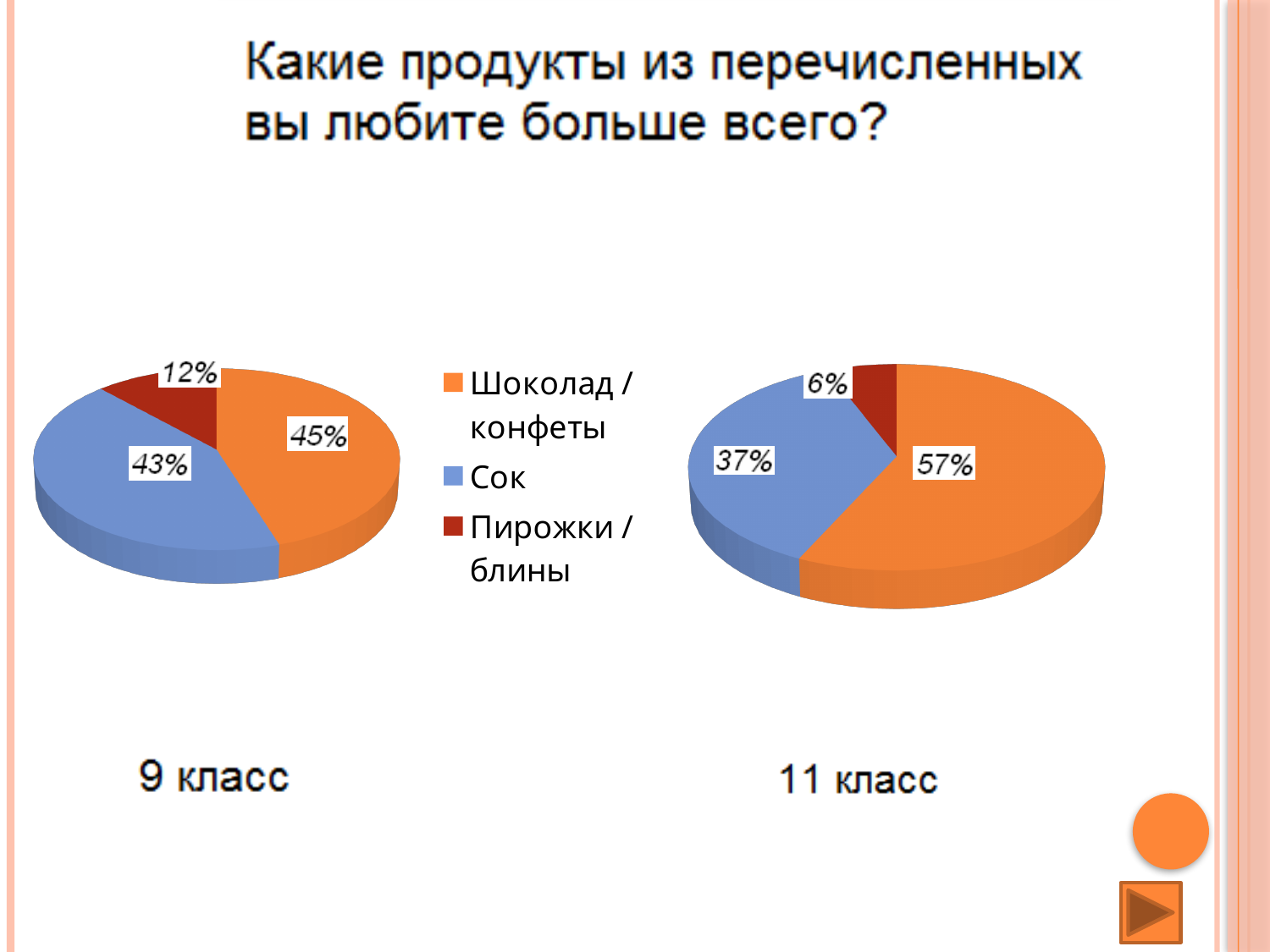
What type of chart is used for the 11 класс data? Pie chart In the 11 класс pie chart, what is the difference between the Сок share and the Пирожки / блины share? 31% In the 9 класс pie chart, what share is labelled for Шоколад / конфеты? 45% In the 9 класс pie chart, which category has the smallest slice? Пирожки / блины In the 11 класс pie chart, what share is labelled for Шоколад / конфеты? 57% In the 11 класс pie chart, what share is labelled for Пирожки / блины? 6% In the 11 класс pie chart, which category has the largest slice? Шоколад / конфеты How many slices does the 9 класс pie chart have? 3 What is the difference between the Шоколад / конфеты share in the 11 класс chart and in the 9 класс chart? 12% Which colour represents Сок in the legend? Blue Which is larger: the Сок share in the 9 класс chart or the Сок share in the 11 класс chart? 9 класс In the 9 класс pie chart, what share is labelled for Сок? 43%